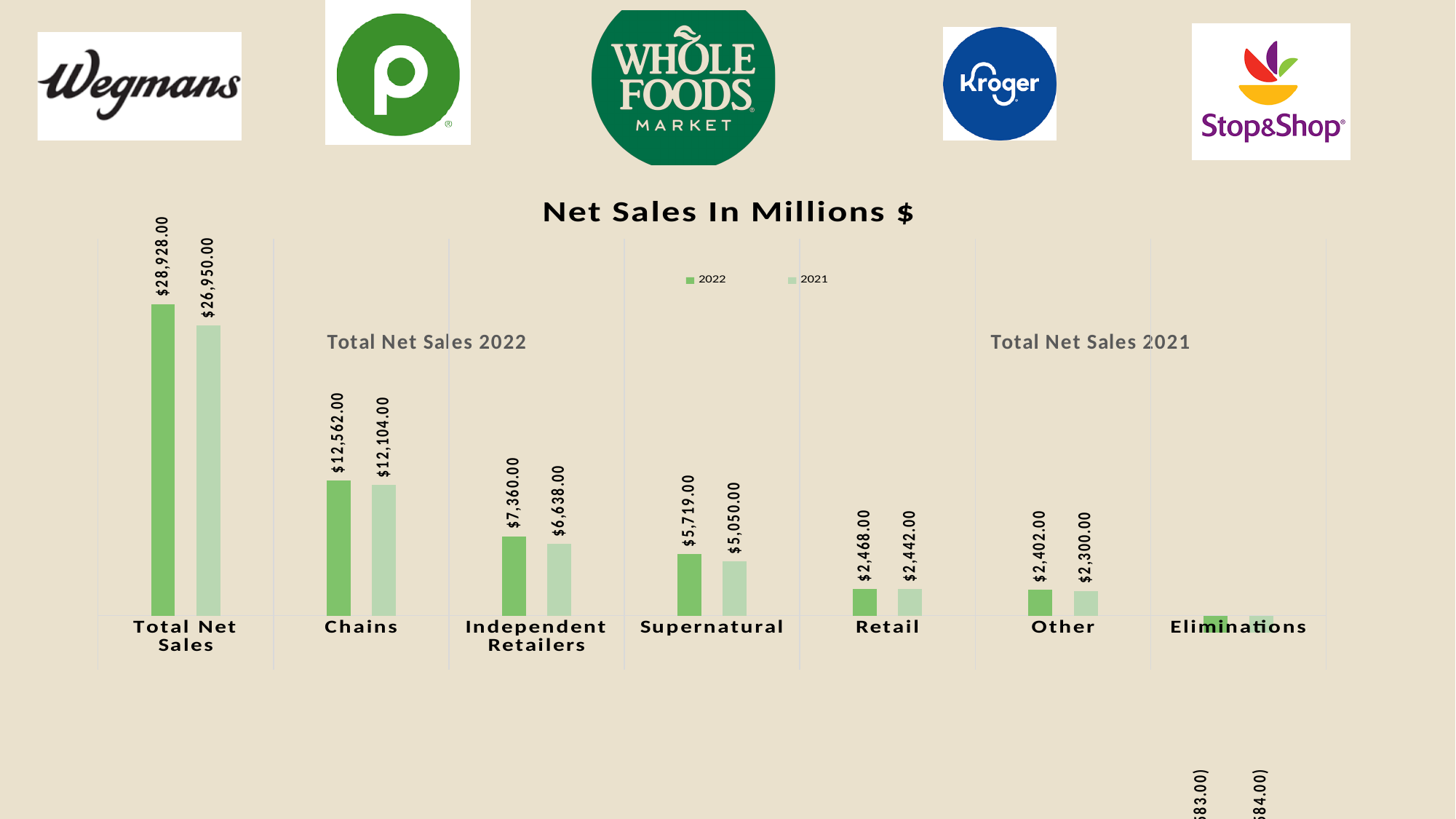
How many series does the legend list? 2 How many categories are shown on the x axis? 7 Excluding Total Net Sales, which category has the lowest 2021 value among Chains, Independent Retailers, Supernatural, Retail and Other? Other Which category has the highest 2022 value? Total Net Sales Which is larger, the 2022 value for Supernatural or the 2022 value for Retail? Supernatural What is the 2022 value for Independent Retailers? $7,360.00 What type of chart is shown on the slide? Bar chart What is the difference between the 2022 and 2021 values for Independent Retailers? $722.00 What is the 2021 value for Supernatural? $5,050.00 What is the 2022 value for Chains? $12,562.00 What is the difference between the 2022 and 2021 values for Total Net Sales? $1,978.00 What is the 2021 value for Other? $2,300.00